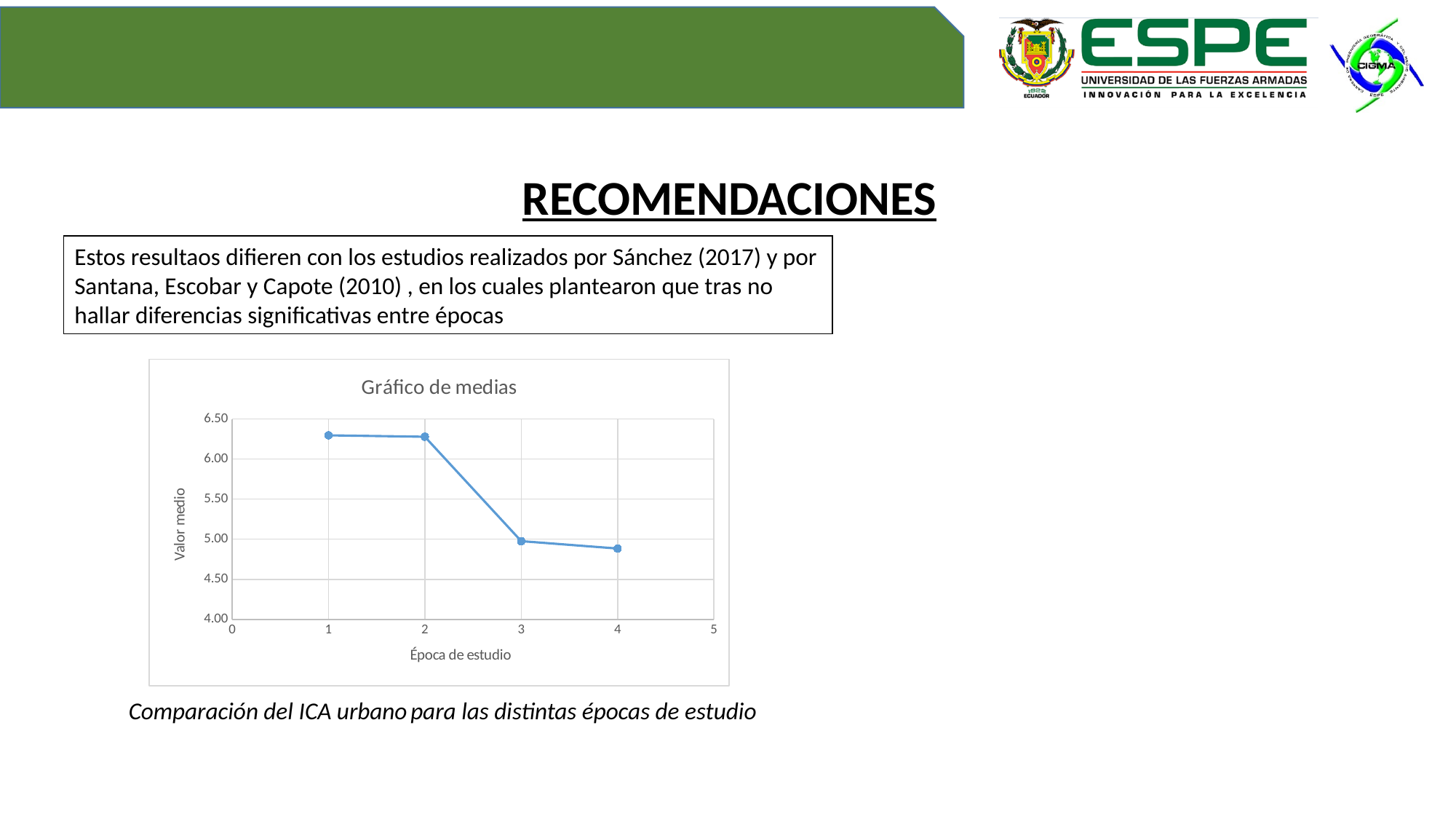
Do the values rise or fall as the época de estudio increases from 1 to 4? fall Which has the larger value, época de estudio 4 or época de estudio 2? época de estudio 2 Is the value for época de estudio 2 greater or less than 6.00? greater Is the value for época de estudio 3 greater or less than 5.50? less What is the title of the chart? Gráfico de medias How many data points are plotted in the chart? 4 Is the value for época de estudio 4 greater or less than 5.50? less What is the label of the y axis of the chart? Valor medio Which has the larger value, época de estudio 1 or época de estudio 3? época de estudio 1 What kind of chart is shown on the slide? line chart